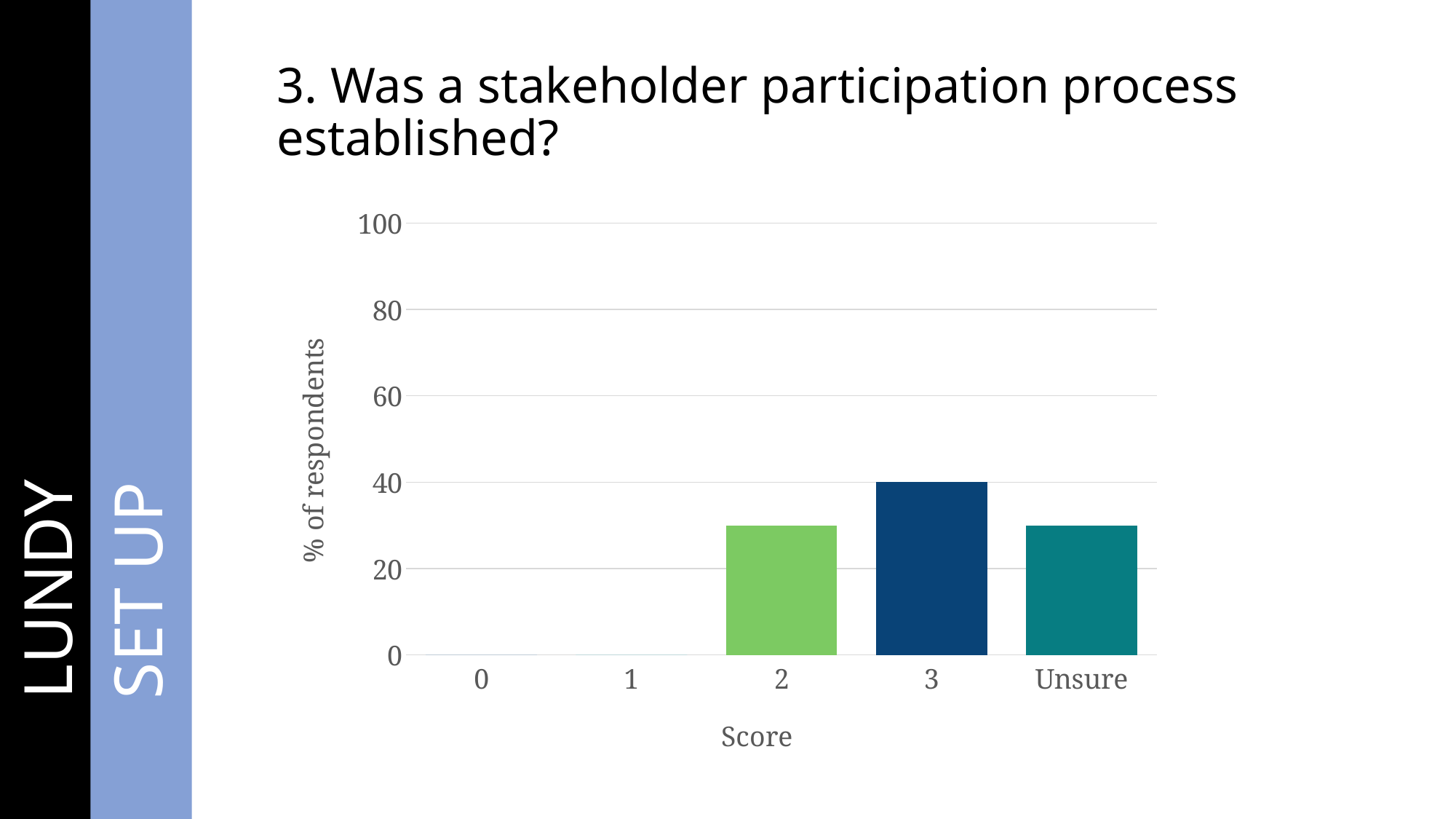
What kind of chart is shown on the slide? bar chart Is the value for score 2 greater or less than 20? greater Which is larger, the value for score 3 or the value for score 2? 3 What is the value for score 1? 0 Which is larger, the value for Unsure or the value for score 1? Unsure How many categories are shown on the x axis? 5 What is the value for score 0? 0 What is the value for score 3? 40 What is the label of the y axis? % of respondents What is the label of the x axis? Score Is the value for Unsure greater or less than 40? less Which category has the highest value? 3